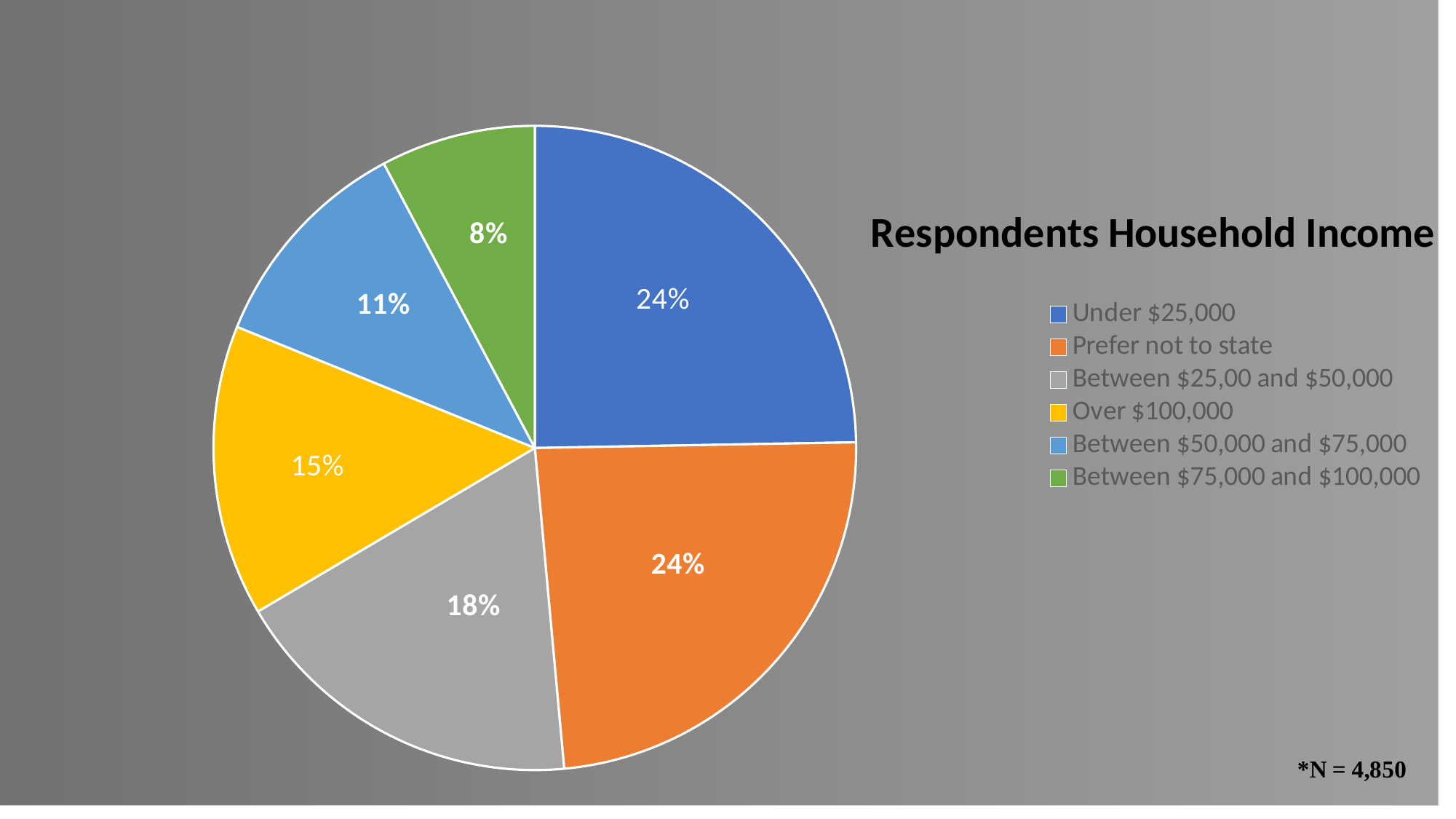
What share of respondents have a household income between $50,000 and $75,000? 11% How many categories does the pie chart have? 6 What kind of chart is shown on the slide? Pie chart Which is larger: the share for 'Between $25,00 and $50,000' or the share for 'Between $50,000 and $75,000'? Between $25,00 and $50,000 What share of respondents have a household income under $25,000? 24% What percentage of respondents have a household income over $100,000? 15% What percentage of respondents preferred not to state their household income? 24% What share of respondents have a household income between $25,00 and $50,000? 18% What colour is the slice for 'Over $100,000'? Yellow What is the title of the chart? Respondents Household Income What is the difference in percentage points between the 'Over $100,000' slice and the 'Between $75,000 and $100,000' slice? 7 percentage points Which income category has the smallest share of respondents? Between $75,000 and $100,000